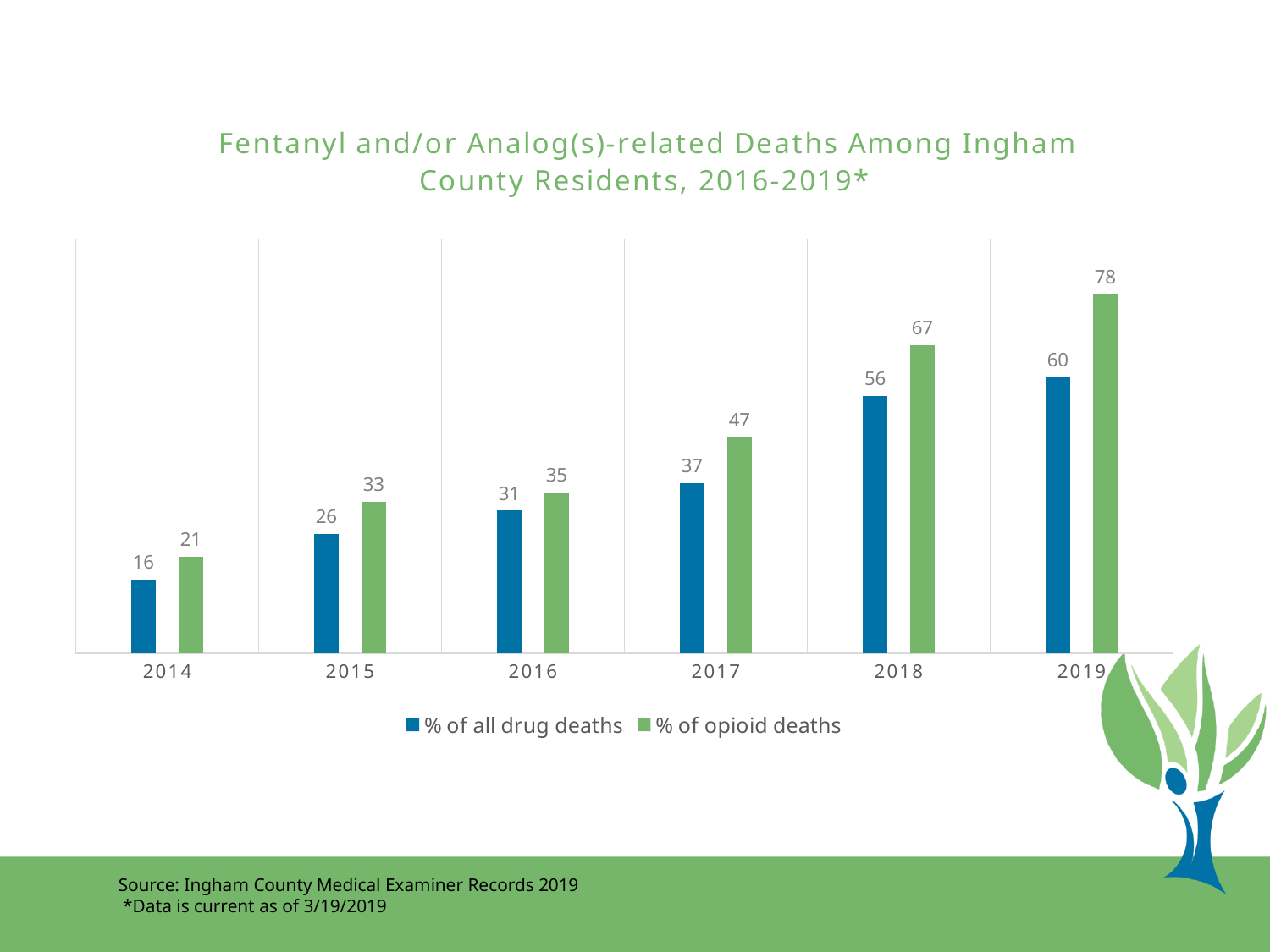
Do the values for % of opioid deaths rise or fall from 2014 to 2019? Rise How many years are shown on the x axis? 6 Which year has the lowest value for % of opioid deaths? 2014 What is the difference between % of opioid deaths and % of all drug deaths in 2018? 11 What kind of chart is shown on the slide? Bar chart Which year has the highest value for % of all drug deaths? 2019 How many series does the legend list? 2 Which is larger in 2016: % of all drug deaths or % of opioid deaths? % of opioid deaths What is the value for % of opioid deaths in 2017? 47 What colour are the bars for % of all drug deaths? Blue What is the value for % of all drug deaths in 2014? 16 What is the value for % of opioid deaths in 2019? 78